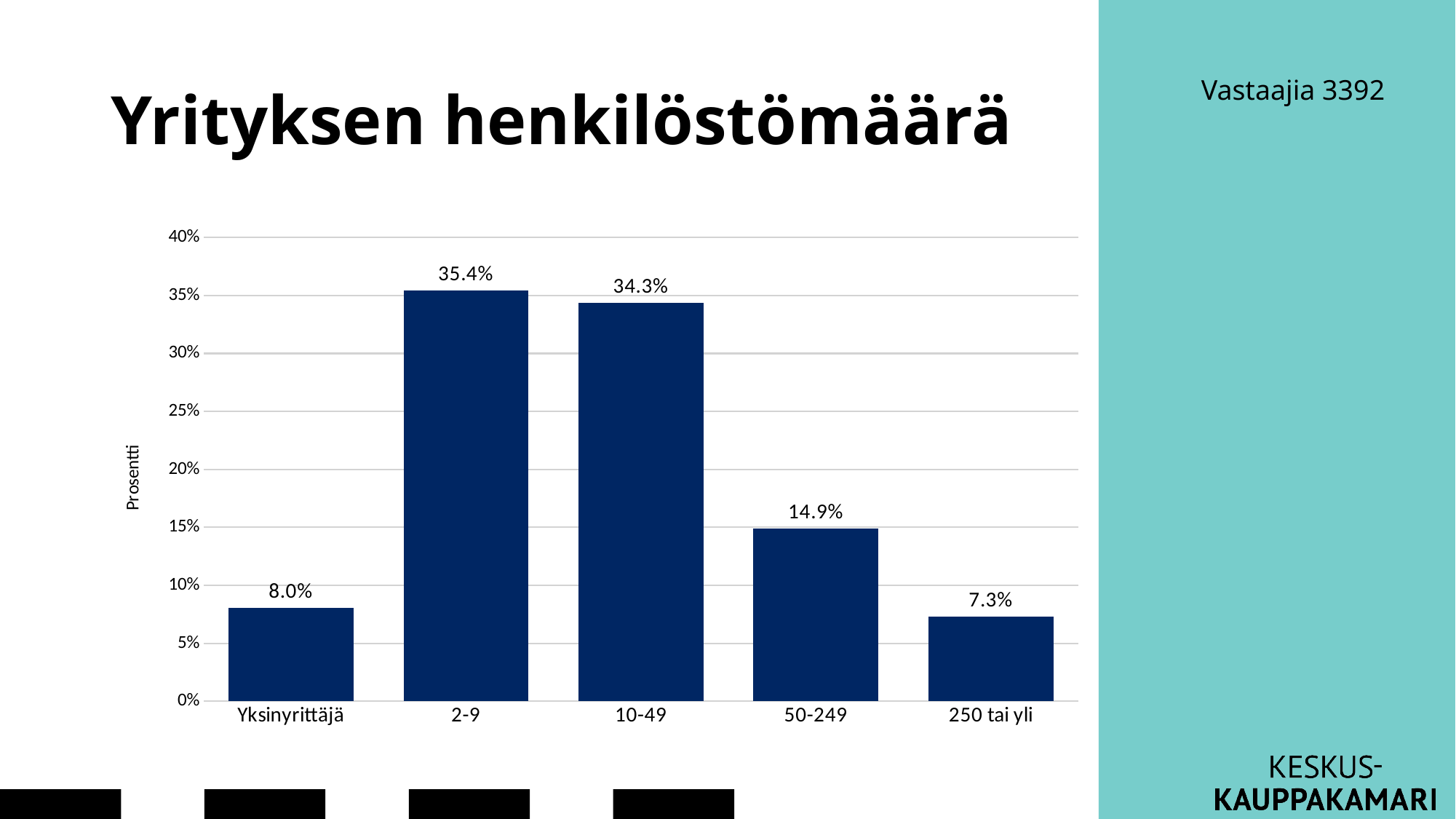
Which is larger, the value for Yksinyrittäjä or the value for 50-249? 50-249 What is the value for the 50-249 category? 14.9% What is the value for Yksinyrittäjä? 8.0% Which category has the lowest value? 250 tai yli What kind of chart is shown on the slide? bar chart How many categories are shown on the x axis? 5 Which category has the highest value? 2-9 What is the value for the 2-9 category? 35.4% What is the difference between the values for 2-9 and 10-49? 1.1% What is the difference between the values for 50-249 and 250 tai yli? 7.6% What is the title of the chart? Yrityksen henkilöstömäärä What is the value for the 250 tai yli category? 7.3%